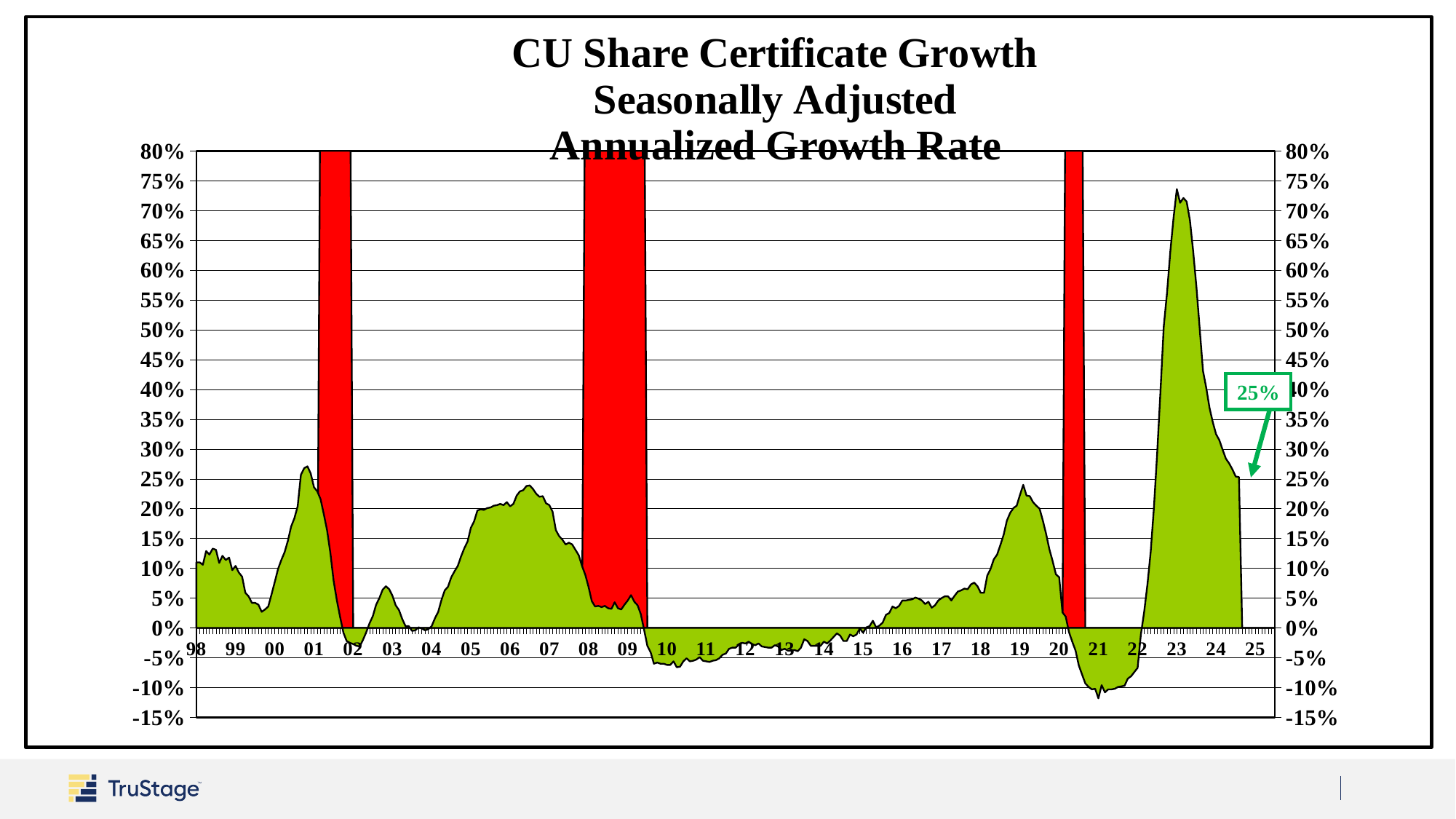
What is the most recent growth rate value called out on the chart? 25% What kind of chart is shown on the slide? area chart Which peak is higher: the one around 2001 or the one around 2023? 2023 How many red shaded bands are shown on the chart? 3 Does the growth rate rise or fall from 2023 to 2025? fall What is the title of the chart? CU Share Certificate Growth Seasonally Adjusted Annualized Growth Rate Is the growth rate in 2021 greater or less than -5%? less Is the peak growth rate in 2023 greater or less than 70%? greater Is the growth rate in 2012 greater or less than 0%? less In which year does the growth rate reach its highest point? 23 What is the highest value shown on the vertical axis? 80% In which year does the growth rate reach its lowest point? 21